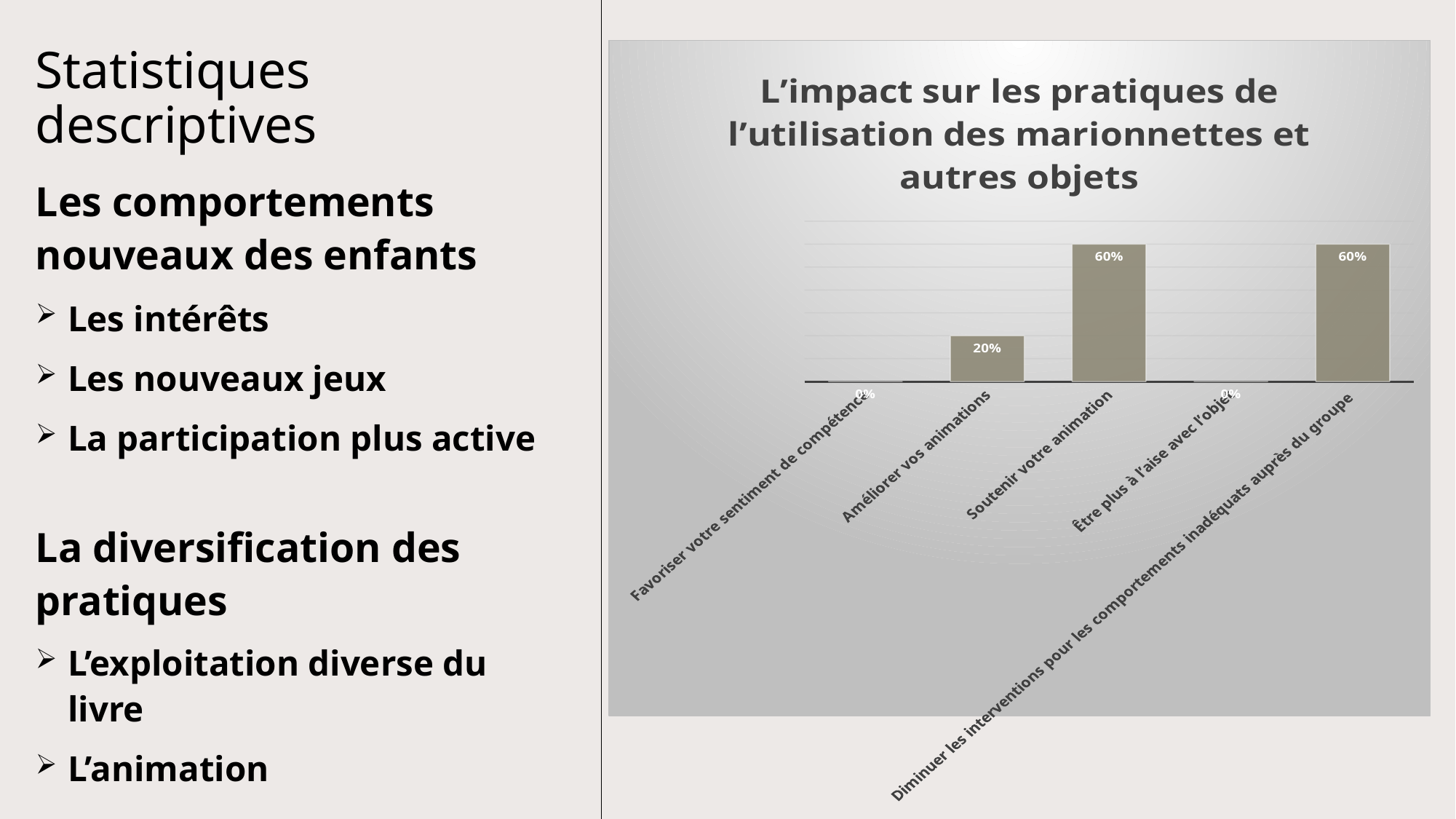
How many categories have a value of 0%? 2 What value is shown for "Diminuer les interventions pour les comportements inadéquats auprès du groupe"? 60% What is the title of the chart? L'impact sur les pratiques de l'utilisation des marionnettes et autres objets What value is shown for "Favoriser votre sentiment de compétence"? 0% What value is shown for "Améliorer vos animations"? 20% How many categories are shown on the x axis of the chart? 5 What value is shown for "Être plus à l'aise avec l'objet"? 0% What kind of chart is shown on the slide? Bar chart What value is shown for "Soutenir votre animation"? 60% Which is larger, the value for "Améliorer vos animations" or the value for "Être plus à l'aise avec l'objet"? Améliorer vos animations Which is larger, the value for "Améliorer vos animations" or the value for "Soutenir votre animation"? Soutenir votre animation What is the difference between the values for "Soutenir votre animation" and "Améliorer vos animations"? 40%